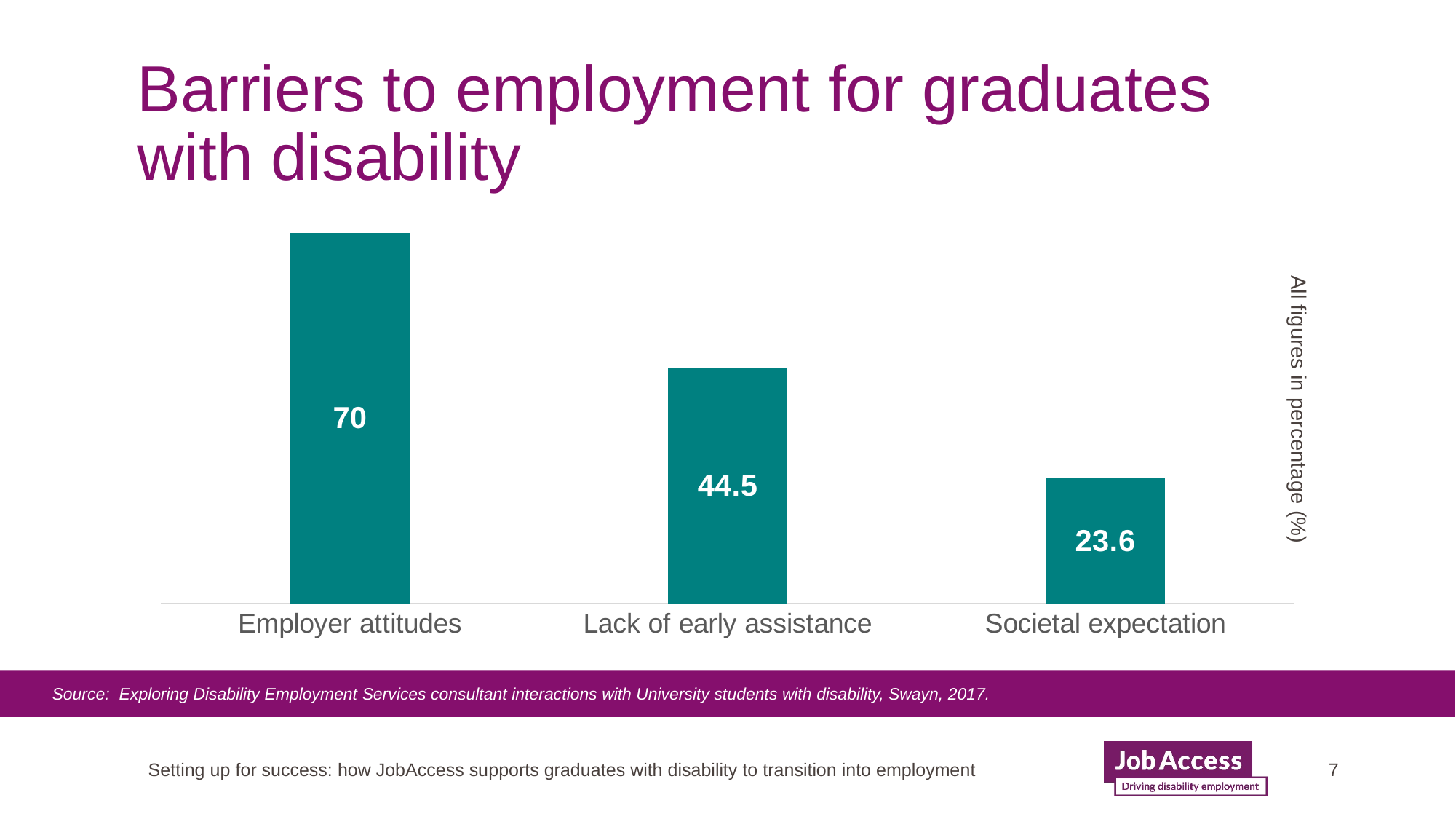
What is the value for Societal expectation? 23.6 Which is larger, the value for Lack of early assistance or the value for Societal expectation? Lack of early assistance What is the difference between the values for Employer attitudes and Lack of early assistance? 25.5 Do the values rise or fall from left to right across the categories? Fall Which barrier has the highest value? Employer attitudes What unit are the figures in the chart expressed in, according to the axis label? Percentage (%) How many categories are shown in the chart? 3 What is the value for Employer attitudes? 70 What is the value for Lack of early assistance? 44.5 Which barrier has the lowest value? Societal expectation What is the difference between the values for Lack of early assistance and Societal expectation? 20.9 What kind of chart is shown on the slide? Bar chart